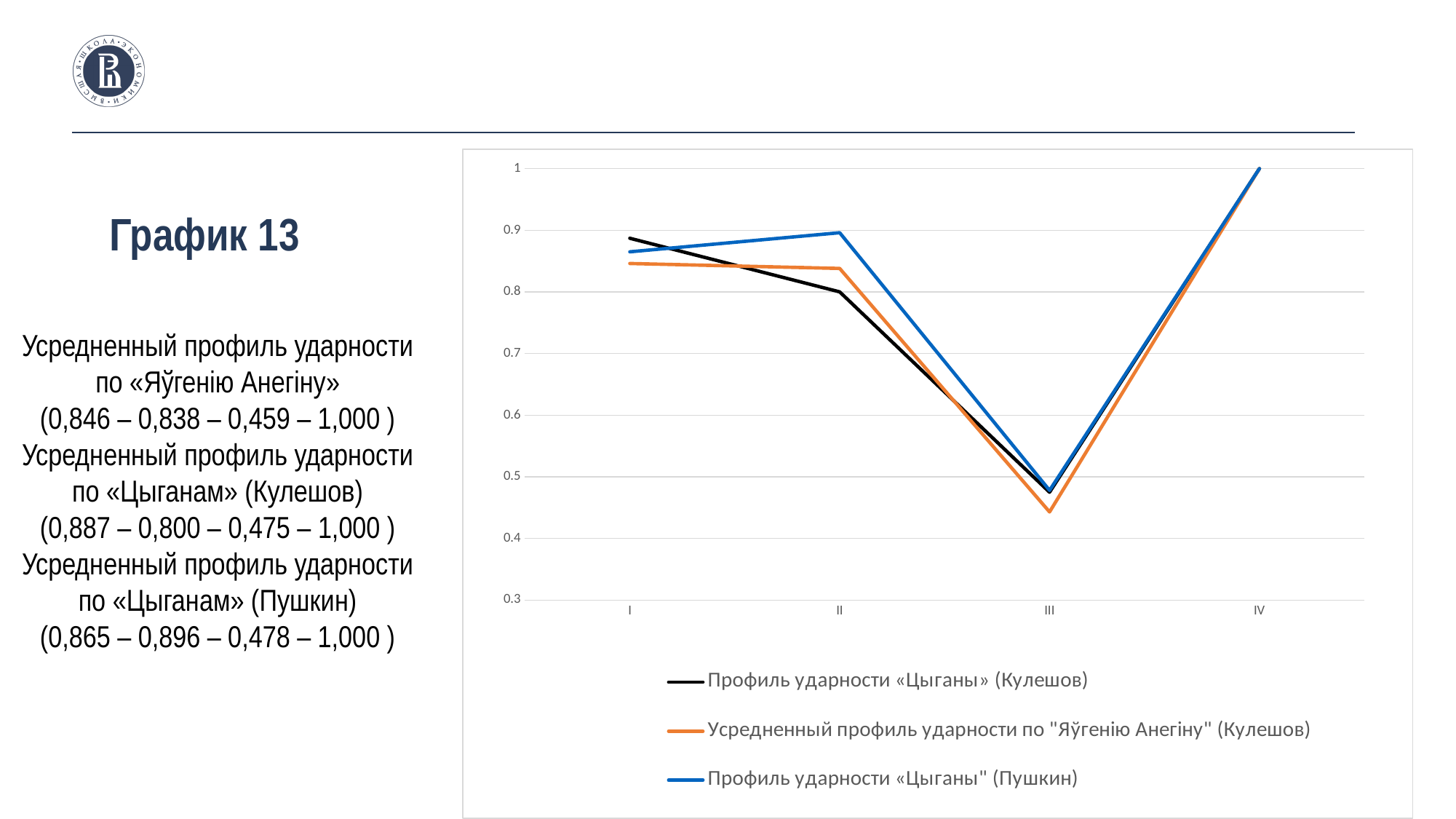
At which x-axis category does the series «Профиль ударности «Цыганы» (Кулешов)» reach its lowest value? III What colour is the line for the series «Профиль ударности «Цыганы" (Пушкин)»? blue What value does the series «Профиль ударности «Цыганы" (Пушкин)» reach at IV? 1 What kind of chart is shown on the slide? line chart Do the values of all three series rise or fall from III to IV? rise At which x-axis category do all three series reach their highest value? IV Is the value of the series «Профиль ударности «Цыганы» (Кулешов)» at II greater or less than 0.9? less How many series does the chart legend list? 3 At II, which series is higher: «Профиль ударности «Цыганы" (Пушкин)» or «Профиль ударности «Цыганы» (Кулешов)»? Профиль ударности «Цыганы" (Пушкин) Is the value of the series «Усредненный профиль ударности по "Яўгенію Анегіну" (Кулешов)» at III greater or less than 0.5? less Is the value of the series «Профиль ударности «Цыганы" (Пушкин)» at II greater or less than 0.8? greater How many points are plotted along the x axis for each series? 4